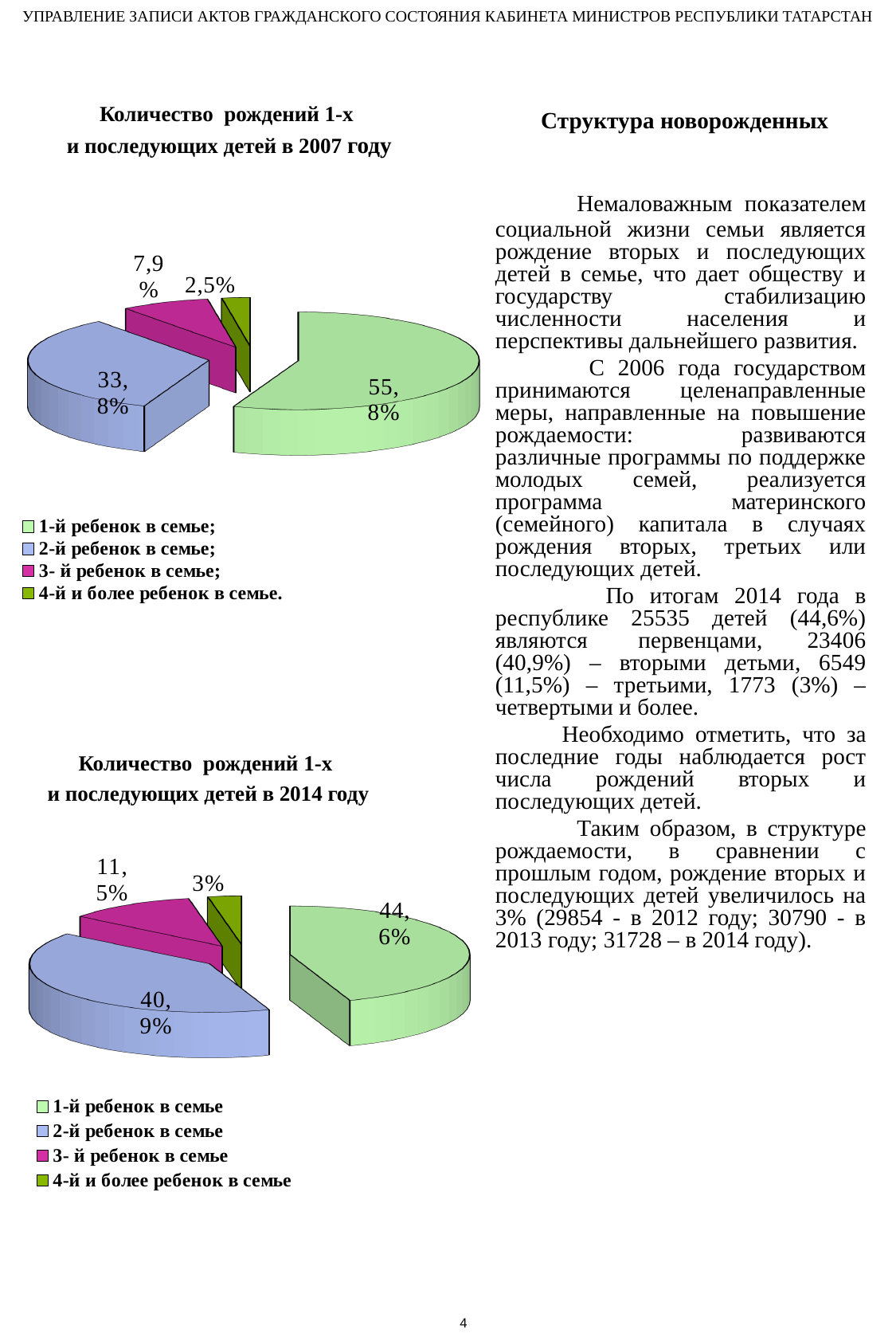
What kind of chart is 'Количество рождений 1-х и последующих детей в 2007 году'? Pie chart In the chart 'Количество рождений 1-х и последующих детей в 2014 году', what colour is the slice for '2-й ребенок в семье'? Blue In the chart 'Количество рождений 1-х и последующих детей в 2014 году', which category has the largest slice? 1-й ребенок в семье In the chart 'Количество рождений 1-х и последующих детей в 2007 году', which is larger: the share for '3- й ребенок в семье' or for '4-й и более ребенок в семье'? 3- й ребенок в семье In the chart 'Количество рождений 1-х и последующих детей в 2007 году', what share is shown for '1-й ребенок в семье'? 55,8% In the chart 'Количество рождений 1-х и последующих детей в 2007 году', what share is shown for '4-й и более ребенок в семье'? 2,5% In the chart 'Количество рождений 1-х и последующих детей в 2014 году', what share is shown for '2-й ребенок в семье'? 40,9% How many slices does the chart 'Количество рождений 1-х и последующих детей в 2014 году' have? 4 In the chart 'Количество рождений 1-х и последующих детей в 2014 году', what share is shown for '3- й ребенок в семье'? 11,5% In the chart 'Количество рождений 1-х и последующих детей в 2014 году', what is the difference between the shares for '1-й ребенок в семье' and '2-й ребенок в семье'? 3,7% In the chart 'Количество рождений 1-х и последующих детей в 2007 году', what share is shown for '2-й ребенок в семье'? 33,8% In the chart 'Количество рождений 1-х и последующих детей в 2007 году', which category has the smallest slice? 4-й и более ребенок в семье